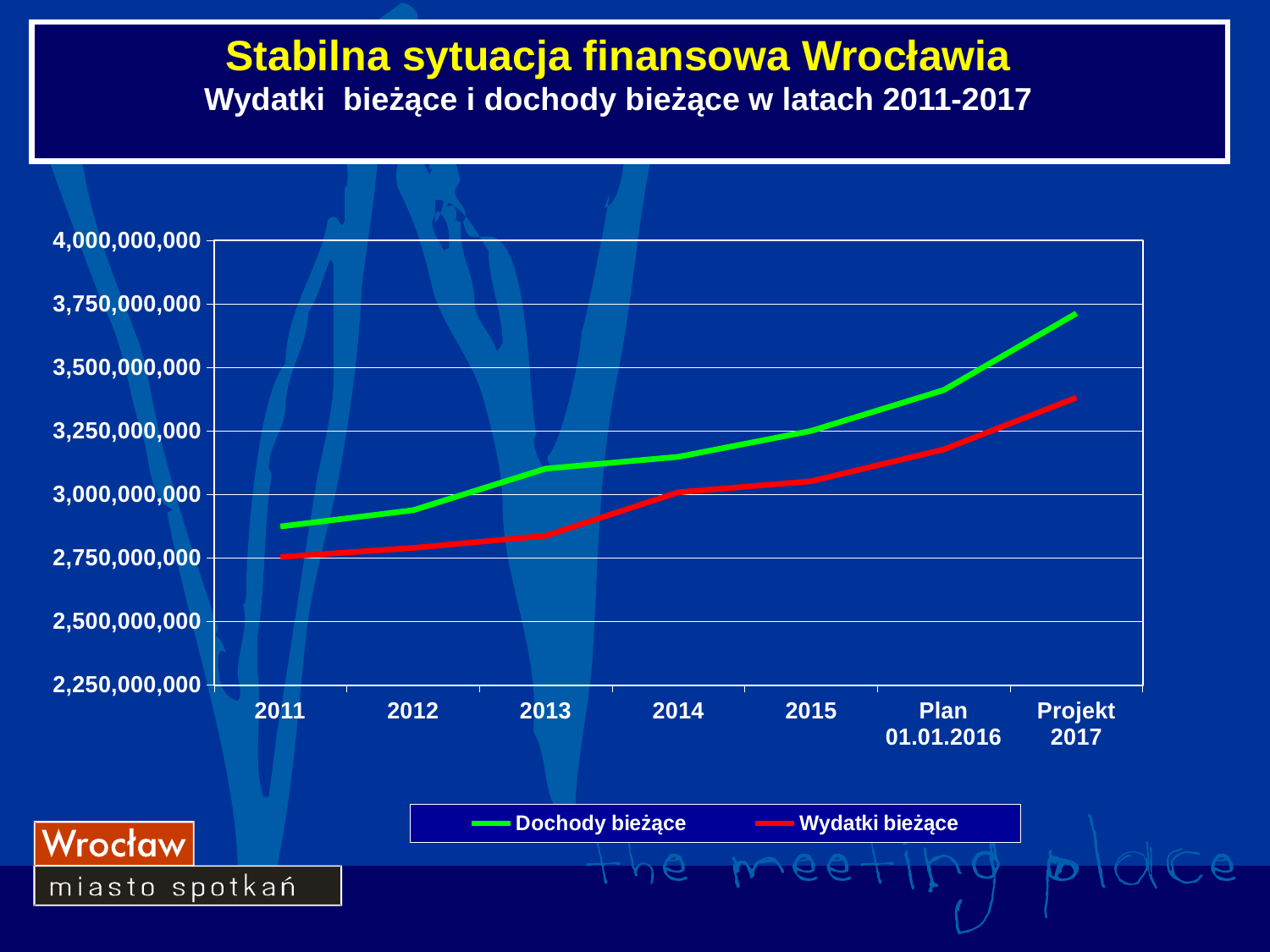
Is the value for Dochody bieżące at Plan 01.01.2016 greater or less than 3,500,000,000? less At which x-axis point is Dochody bieżące highest? Projekt 2017 Which series is drawn in green? Dochody bieżące Is the value for Wydatki bieżące at Projekt 2017 greater or less than 3,250,000,000? greater Is the value for Dochody bieżące in 2011 greater or less than 3,000,000,000? less What is the title of the chart? Stabilna sytuacja finansowa Wrocławia How many points along the x axis does each line have? 7 Do the values for Dochody bieżące rise or fall from 2011 to Projekt 2017? rise In 2015, which is larger: Dochody bieżące or Wydatki bieżące? Dochody bieżące How many series does the legend list? 2 At which x-axis point is Wydatki bieżące lowest? 2011 What kind of chart is shown on the slide? line chart